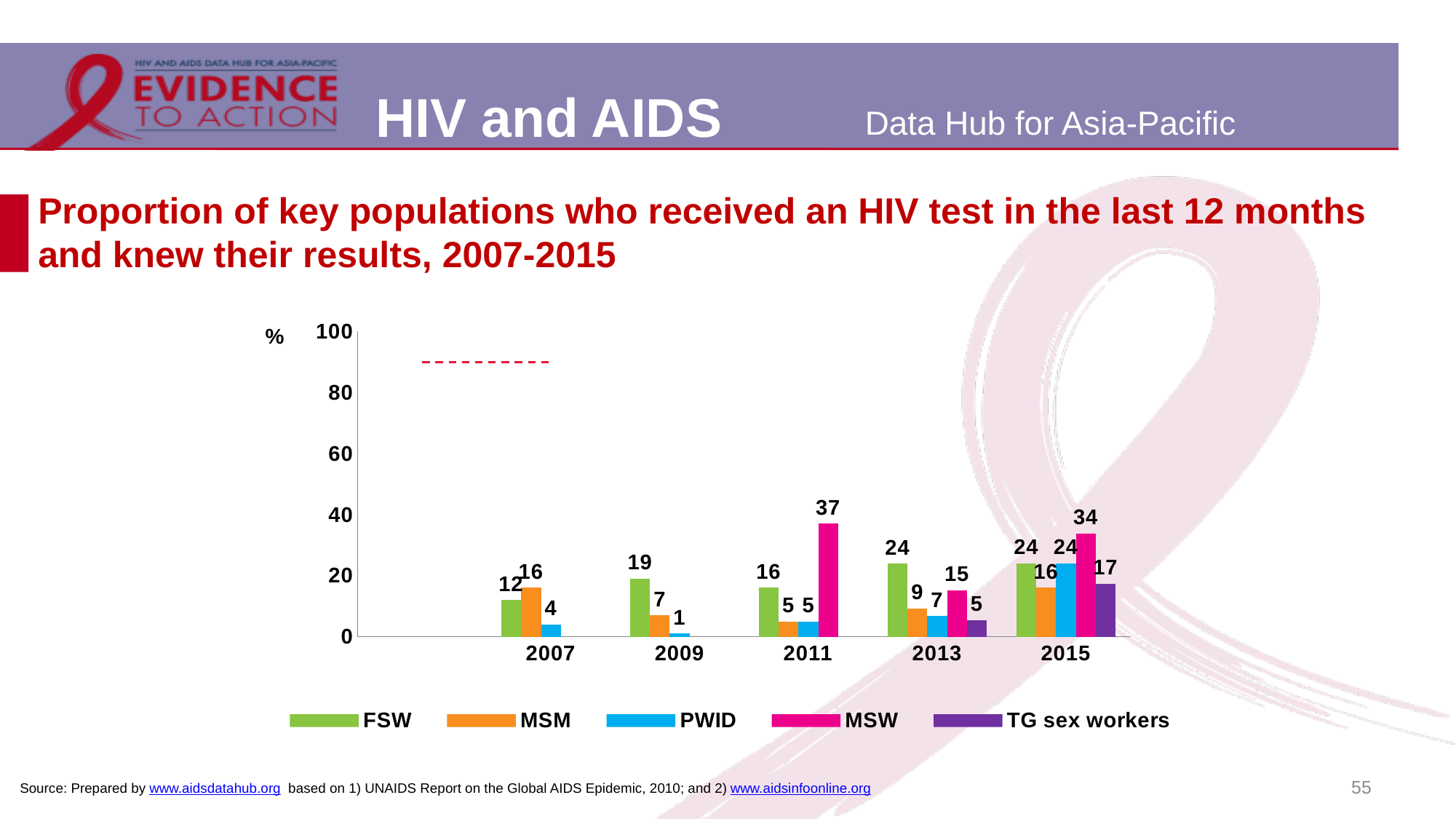
How many series does the legend list? 5 Which series and year has the lowest value in the chart? PWID in 2009 In 2015, which is larger: the value for MSW or the value for TG sex workers? MSW What is the difference between the FSW and MSM values in 2013? 15 What is the value for FSW in 2009? 19 What is the value for MSW in 2011? 37 How many years are shown on the x axis? 5 Does the value for TG sex workers rise or fall from 2013 to 2015? Rise Which series and year has the highest value in the chart? MSW in 2011 What is the value for PWID in 2015? 24 What kind of chart is shown on the slide? Bar chart What is the value for TG sex workers in 2013? 5